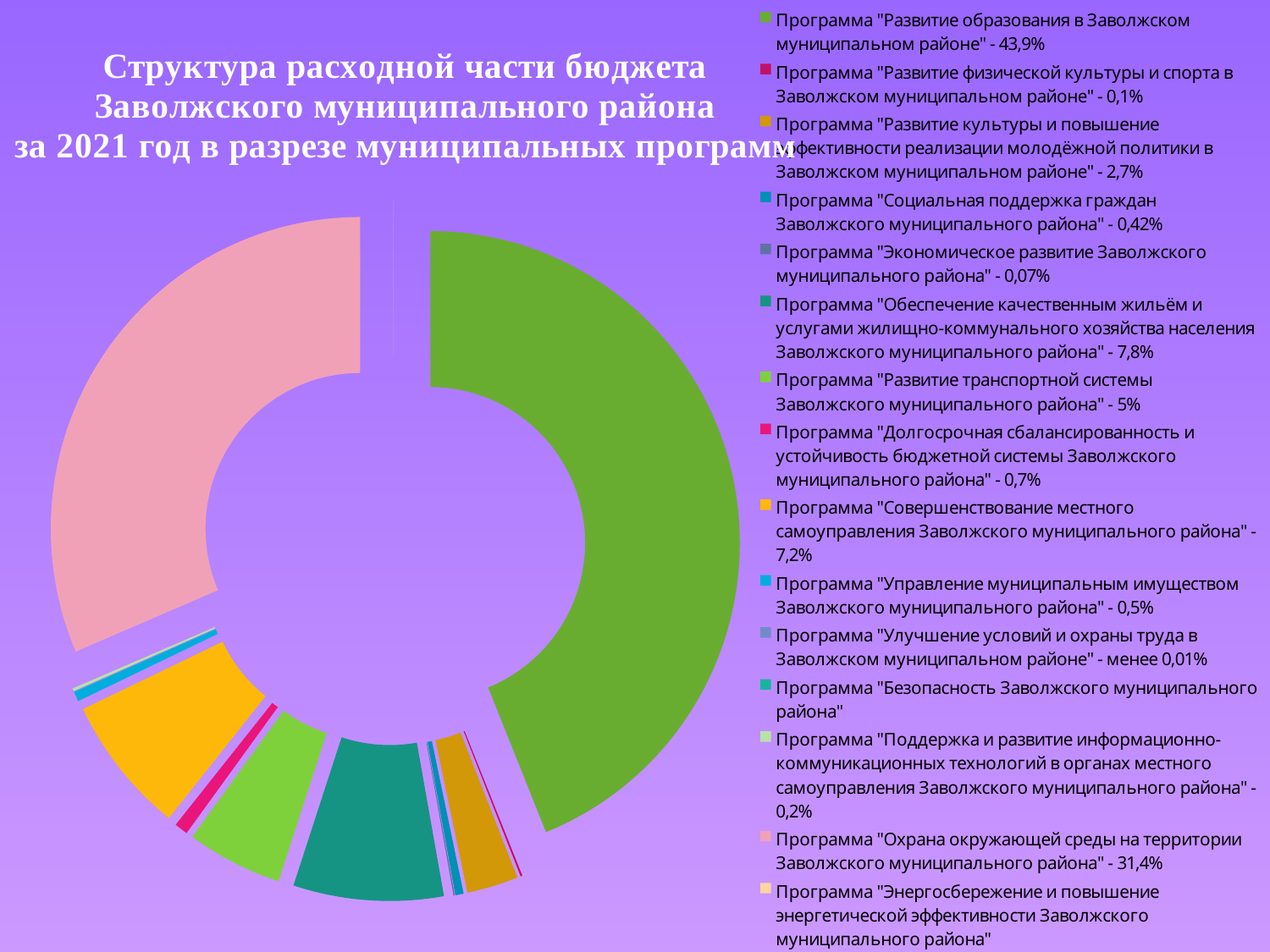
What share is shown for the programme "Охрана окружающей среды на территории Заволжского муниципального района"? 31,4% What share of the budget expenditure goes to the programme "Развитие образования в Заволжском муниципальном районе"? 43,9% Which has the larger share: the housing and utilities programme ("Обеспечение качественным жильём...") or the local self-government programme ("Совершенствование местного самоуправления...")? Обеспечение качественным жильём и услугами жилищно-коммунального хозяйства What kind of chart is shown on the slide? Doughnut (pie) chart What is the difference in percentage points between the education programme (43,9%) and the environmental protection programme (31,4%)? 12,5% What is the title of the chart? Структура расходной части бюджета Заволжского муниципального района за 2021 год в разрезе муниципальных программ How many programmes are listed in the chart legend? 15 What share is shown for the programme "Социальная поддержка граждан Заволжского муниципального района"? 0,42% What is the difference between the housing and utilities programme (7,8%) and the local self-government programme (7,2%)? 0,6% What share is shown for the programme "Обеспечение качественным жильём и услугами жилищно-коммунального хозяйства населения Заволжского муниципального района"? 7,8% What share is shown for the programme "Развитие транспортной системы Заволжского муниципального района"? 5% Which programme has the largest share of the budget expenditure? Программа "Развитие образования в Заволжском муниципальном районе"